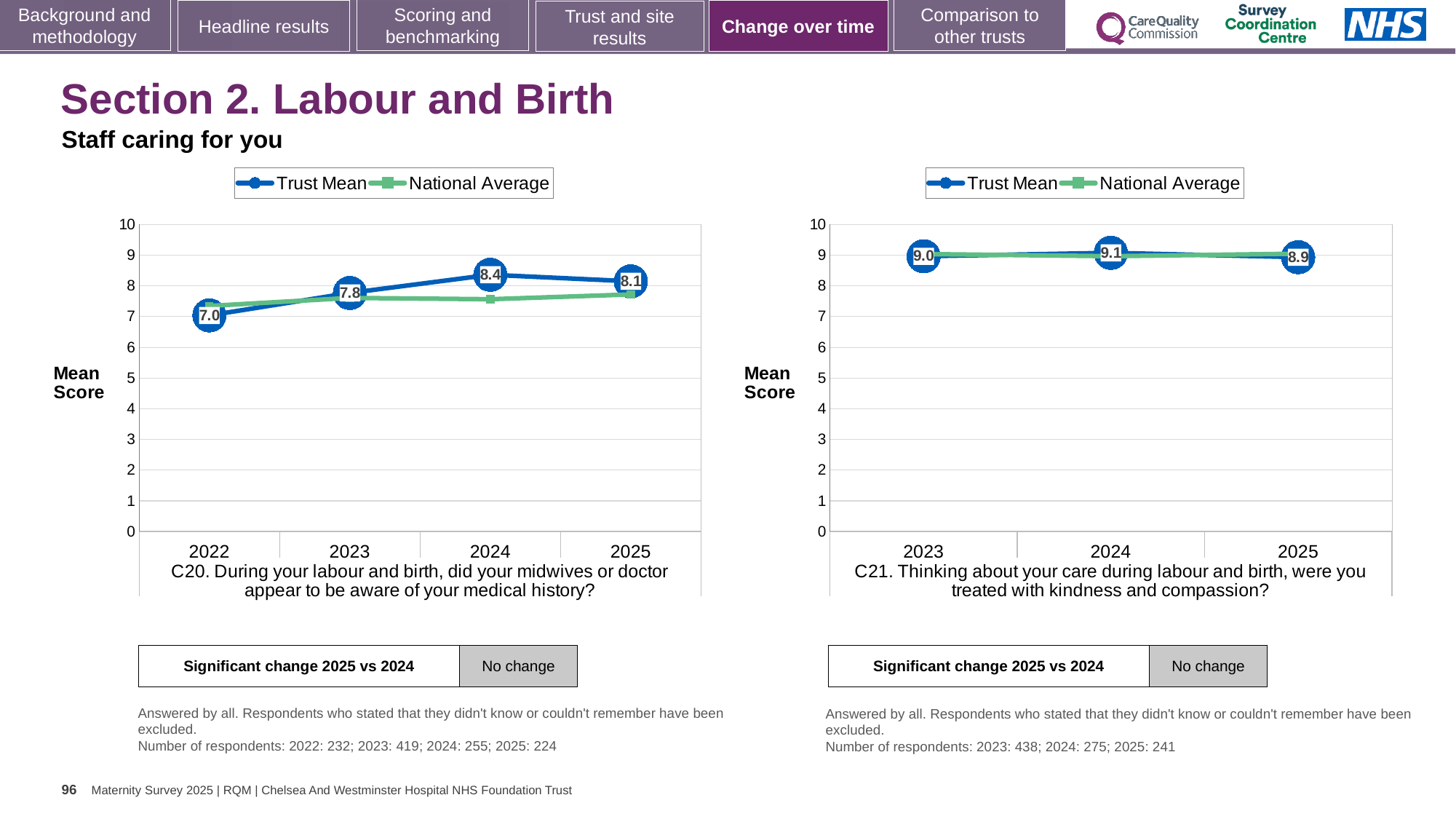
In the C21 chart (right), which year has the highest Trust Mean? 2024 In the C20 chart (left), what is the Trust Mean for 2022? 7.0 In the C20 chart (left), which year has the lowest Trust Mean? 2022 In the C21 chart (right), how many series does the legend list? 2 What kind of chart is the C20 chart on the left? Line chart In the C20 chart (left), how many years are plotted on the x axis? 4 In the C20 chart (left), what is the Trust Mean for 2024? 8.4 In the C20 chart (left), is the National Average for 2022 greater or less than 6? greater In the C21 chart (right), is the Trust Mean for 2023 larger or smaller than the Trust Mean for 2025? larger In the C21 chart (right), what is the Trust Mean for 2025? 8.9 In the C20 chart (left), which year has the highest Trust Mean? 2024 In the C20 chart (left), what is the difference between the Trust Mean for 2024 and 2025? 0.3